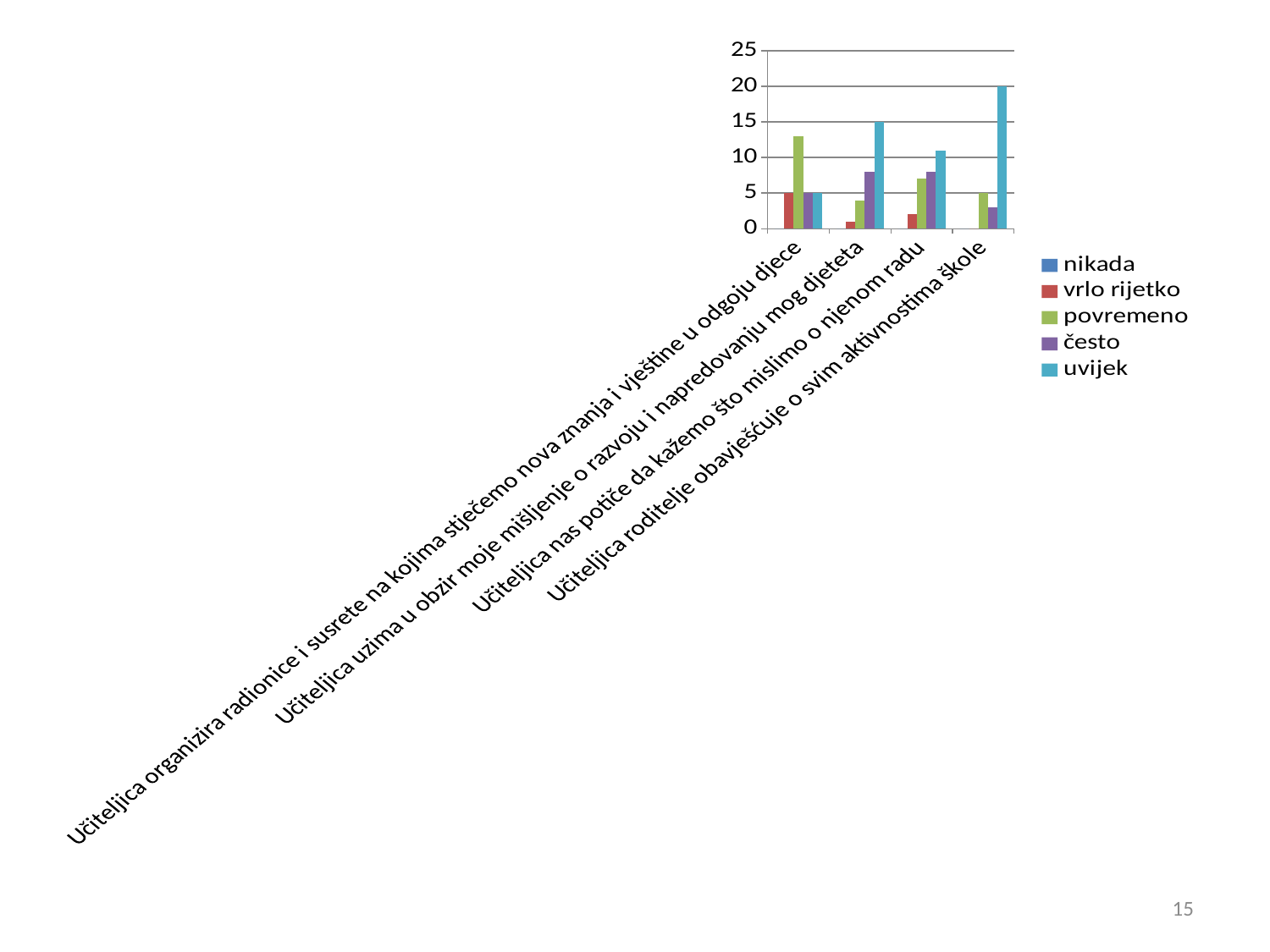
What is the value of "uvijek" for "Učiteljica roditelje obavješćuje o svim aktivnostima škole"? 20 Is the value of "često" for "Učiteljica uzima u obzir moje mišljenje o razvoju i napredovanju mog djeteta" greater or less than 10? less What kind of chart is shown on the slide? bar chart Which series is shown in light blue in the legend? uvijek Which category has the highest "uvijek" bar? Učiteljica roditelje obavješćuje o svim aktivnostima škole How many categories are shown on the x axis? 4 Is the value of "povremeno" for "Učiteljica organizira radionice i susrete na kojima stječemo nova znanja i vještine u odgoju djece" greater or less than 10? greater How many series does the legend list? 5 What is the value of "uvijek" for "Učiteljica uzima u obzir moje mišljenje o razvoju i napredovanju mog djeteta"? 15 Which is larger for "Učiteljica nas potiče da kažemo što mislimo o njenom radu": "uvijek" or "vrlo rijetko"? uvijek Which series is listed first in the legend? nikada Which series has the highest bar for "Učiteljica organizira radionice i susrete na kojima stječemo nova znanja i vještine u odgoju djece"? povremeno